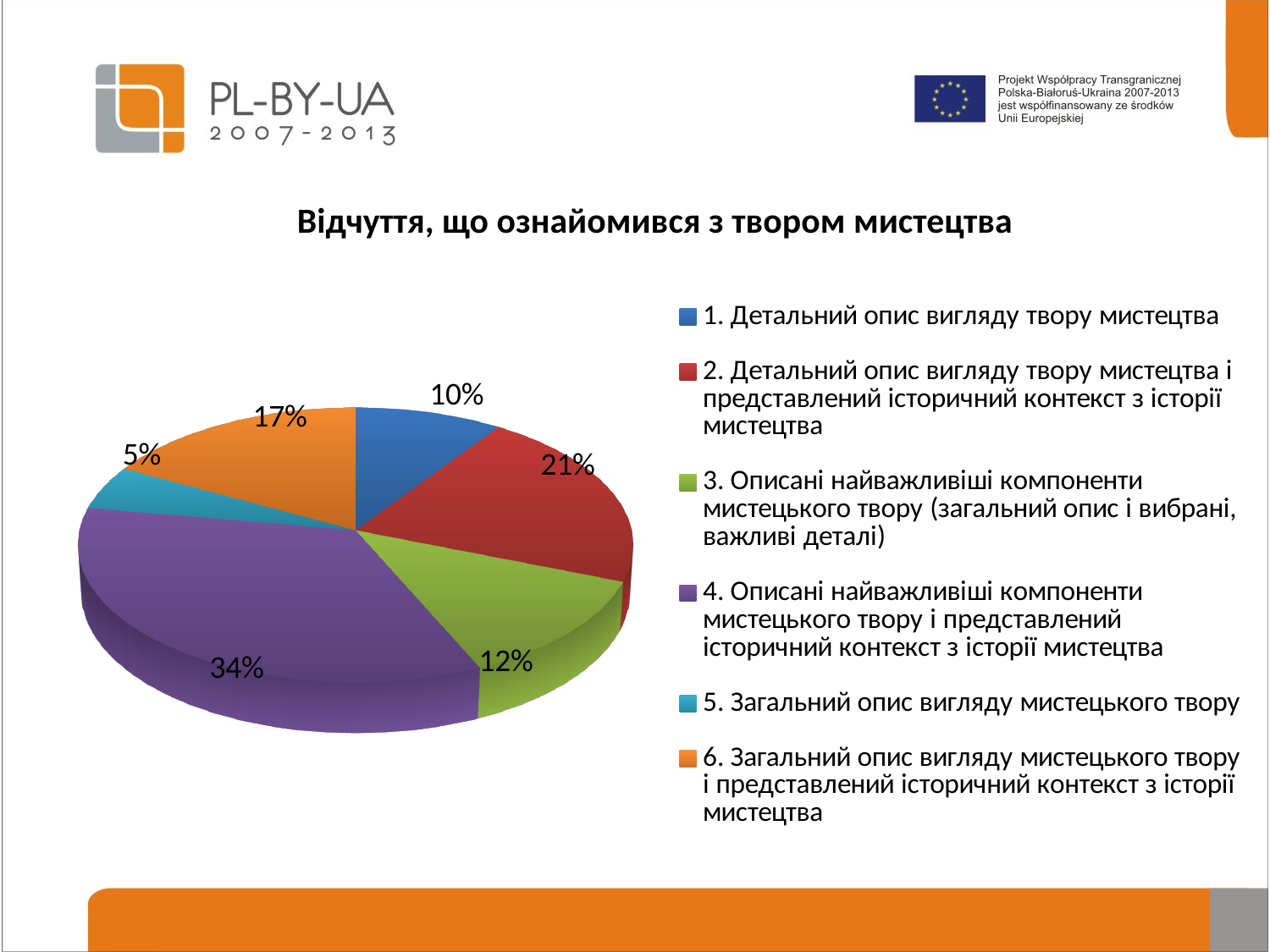
Which is larger: the share for category 2 ("Детальний опис вигляду твору мистецтва і представлений історичний контекст з історії мистецтва") or category 6 ("Загальний опис вигляду мистецького твору і представлений історичний контекст з історії мистецтва")? category 2 What is the title of the chart? Відчуття, що ознайомився з твором мистецтва What is the difference in percentage points between category 2 (21%) and category 3 (12%)? 9 Which category has the largest share of the pie? 4. Описані найважливіші компоненти мистецького твору і представлений історичний контекст з історії мистецтва Which category has the smallest share of the pie? 5. Загальний опис вигляду мистецького твору How many slices does the pie chart have? 6 What colour is the slice for category "3. Описані найважливіші компоненти мистецького твору (загальний опис і вибрані, важливі деталі)"? green What share of the pie does category "5. Загальний опис вигляду мистецького твору" have? 5% What share of the pie does category "6. Загальний опис вигляду мистецького твору і представлений історичний контекст з історії мистецтва" have? 17% What share of the pie does category "1. Детальний опис вигляду твору мистецтва" have? 10% What type of chart is shown on the slide? pie chart